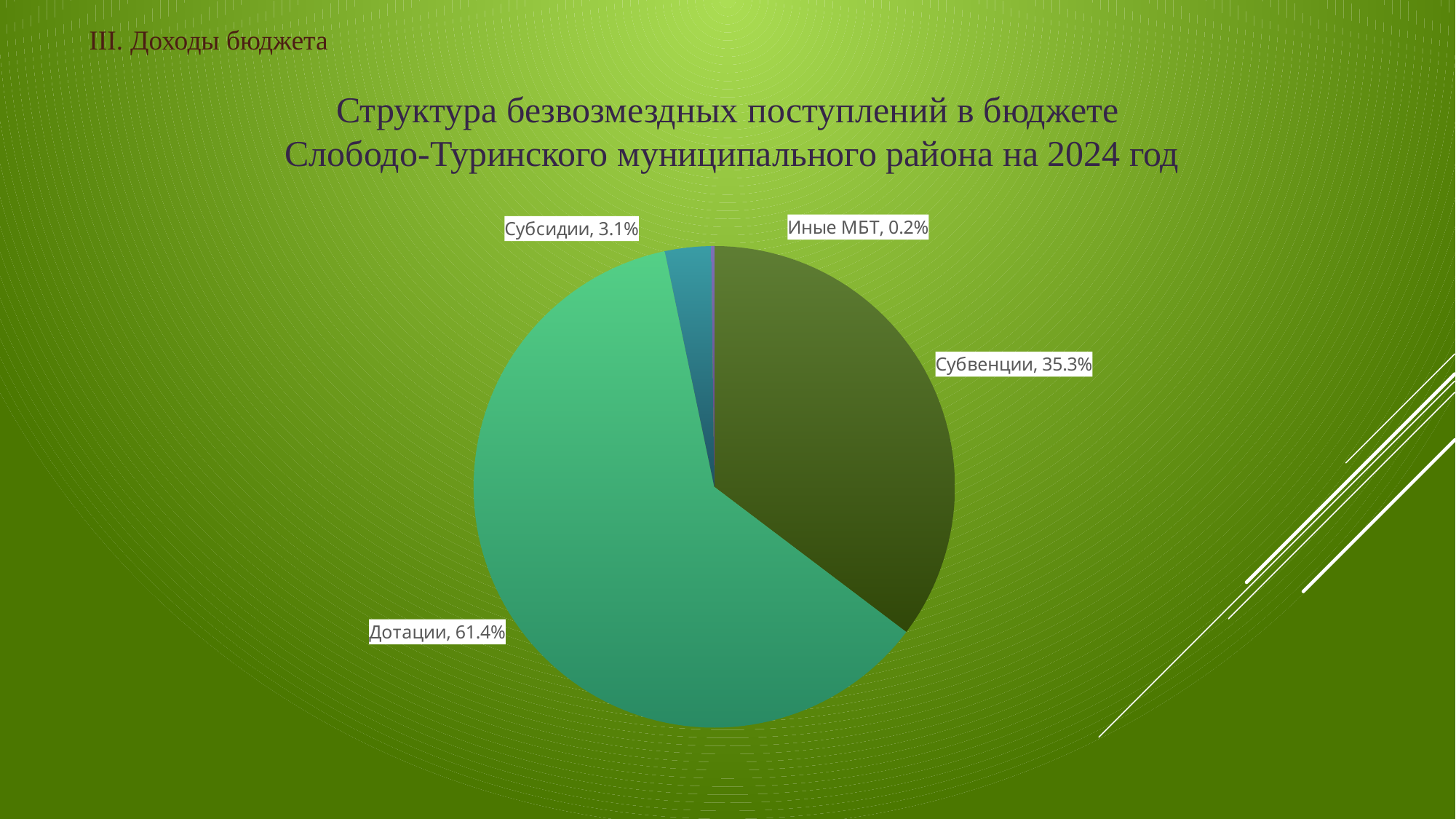
Which category has the largest slice of the pie? Дотации How many categories are shown in the pie chart? 4 What is the value shown for Иные МБТ? 0.2% Which is larger, the share of Субсидии or the share of Иные МБТ? Субсидии What is the title of the chart? Структура безвозмездных поступлений в бюджете Слободо-Туринского муниципального района на 2024 год What is the value shown for Субсидии? 3.1% What share of the pie does Дотации account for? 61.4% What is the combined share of Субсидии and Иные МБТ? 3.3% What kind of chart is shown on the slide? Pie chart What is the difference between the shares of Дотации and Субвенции? 26.1% Which category has the smallest slice of the pie? Иные МБТ What is the value shown for Субвенции? 35.3%